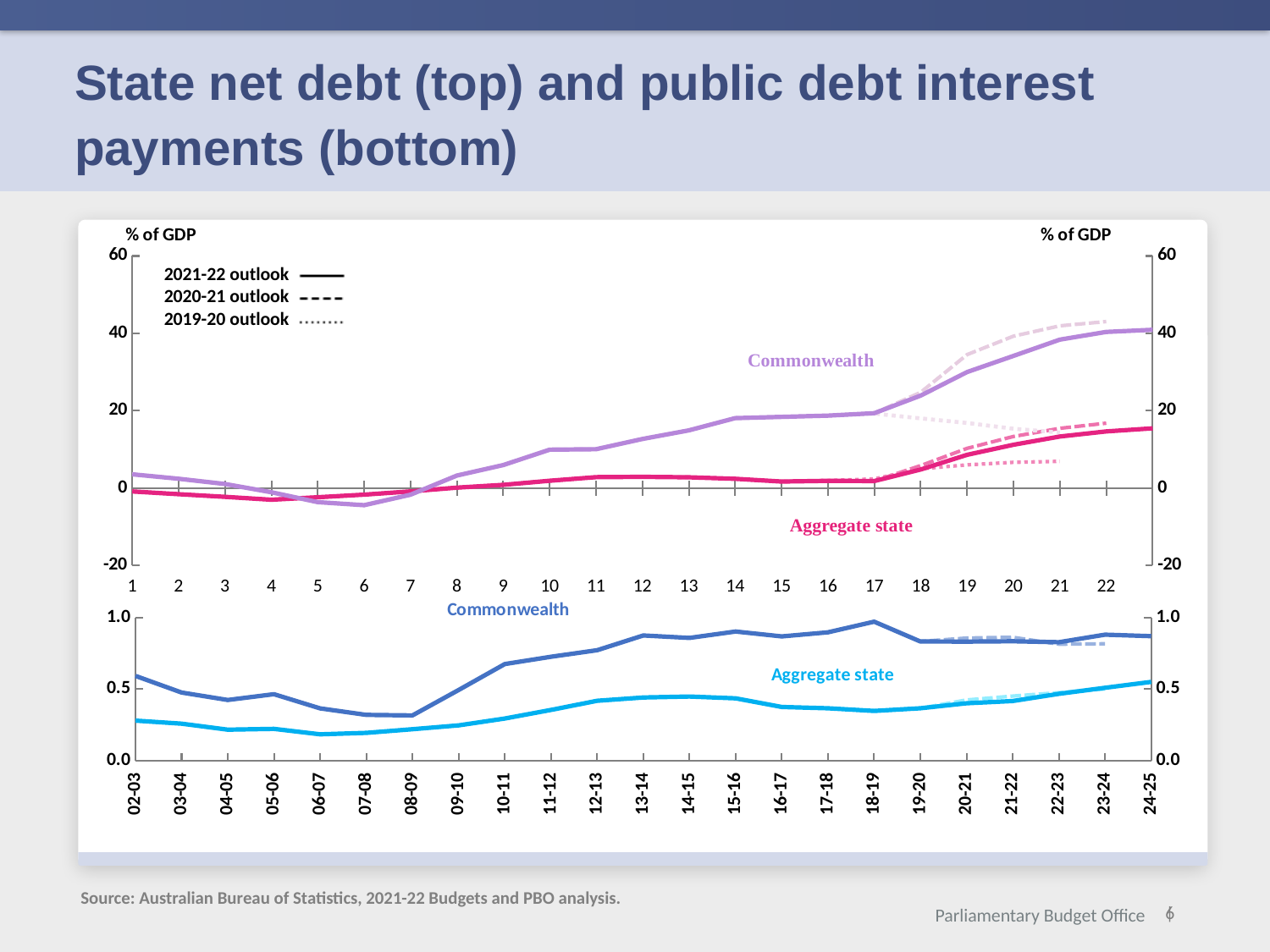
In the top chart, does the Commonwealth line rise or fall from point 7 to point 22? Rise In the top chart, how many outlook series does the legend list? 3 In the bottom chart, which series is larger in 18-19, Commonwealth or Aggregate state? Commonwealth In the top chart, is the Aggregate state value at point 22 greater or less than 20? less In the bottom chart, in which year is the Commonwealth line at its highest? 18-19 In the bottom chart, how many years are labelled on the x axis? 23 In the top chart, at which x-axis point is the Commonwealth line at its lowest? 6 What kind of chart is the top chart (State net debt)? Line chart In the top chart, is the Commonwealth value at point 20 greater or less than 20? greater In the bottom chart, is the Aggregate state value for 06-07 greater or less than 0.5? less What kind of chart is the bottom chart (public debt interest payments)? Line chart